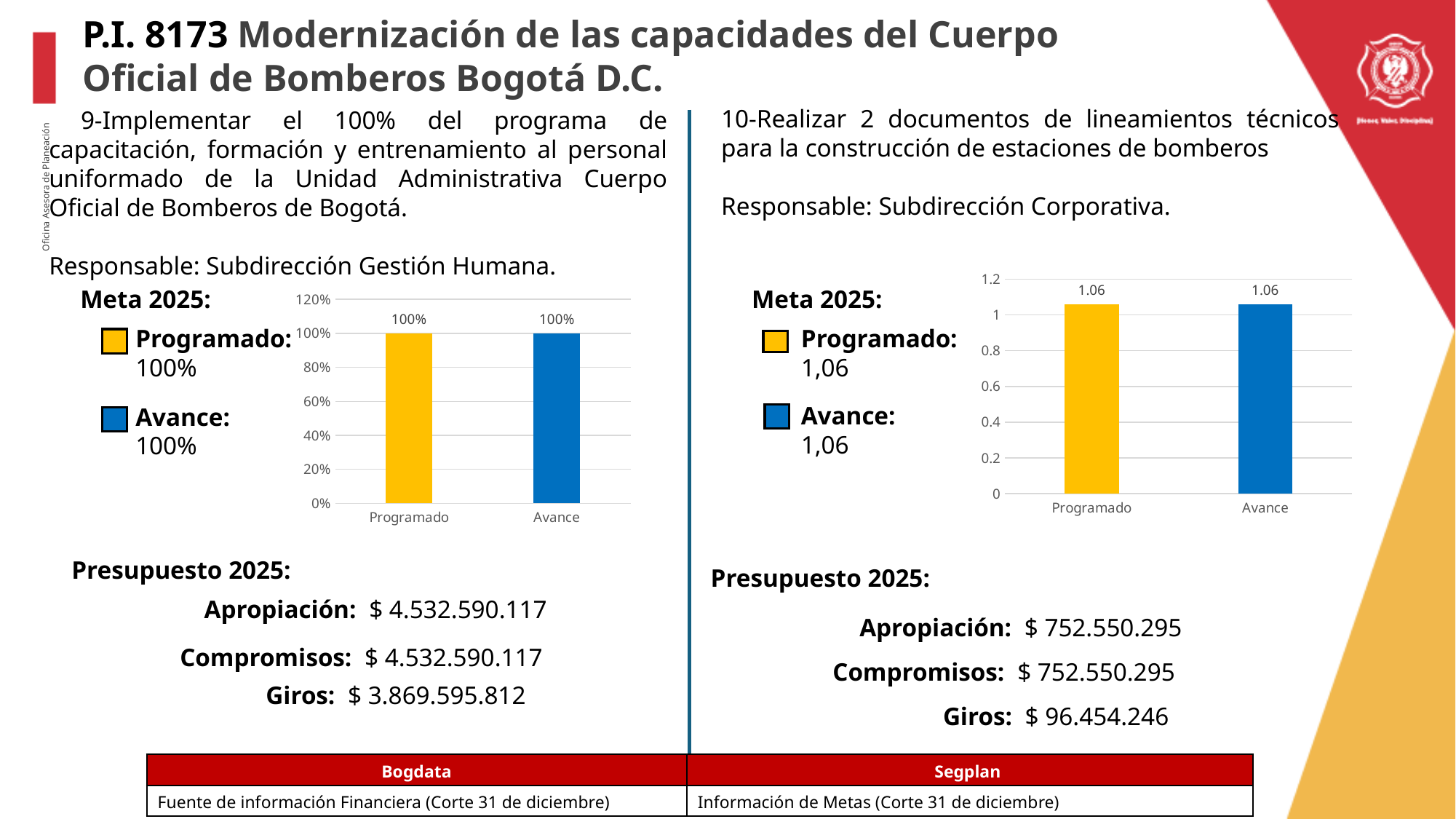
In the left chart, what is the difference between the Programado and Avance values? 0% In the left chart, is the value for Programado greater or less than 80%? greater How many bars are plotted in the left chart? 2 In the right chart, is the value for Avance greater or less than 1? greater In the right chart, what is the difference between the Programado and Avance values? 0 In the right chart, what is the value for Programado? 1.06 What kind of chart is the right chart? Bar chart In the left chart, what is the value for Programado? 100% In the left chart, what colour is the Programado bar? Yellow In the left chart, what is the value for Avance? 100% In the right chart, what is the value for Avance? 1.06 How many categories are shown on the x axis of the right chart? 2